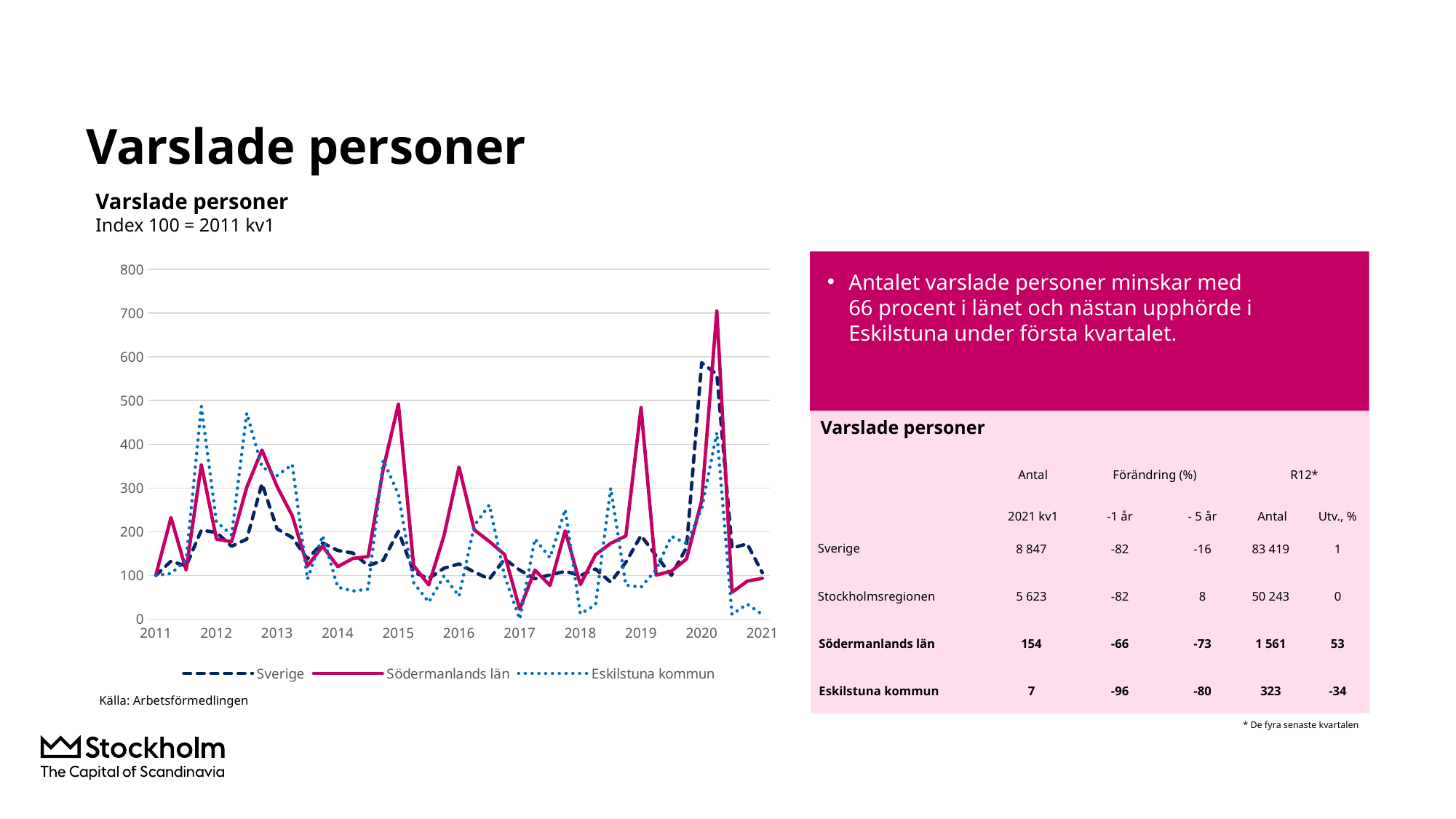
What kind of chart is shown on the slide? line chart Is the peak value for Södermanlands län in 2015 greater or less than 400? greater How many series does the chart legend list? 3 What is the title of the chart? Varslade personer Is the peak value for Eskilstuna kommun in 2020 greater or less than 500? less Which series reaches the highest value anywhere on the chart? Södermanlands län How many year labels are shown on the x axis? 11 Is the peak value for Sverige in 2020 greater or less than 500? greater Which series are listed in the chart legend? Sverige, Södermanlands län, Eskilstuna kommun Which series has the higher peak in 2020, Sverige or Eskilstuna kommun? Sverige What is the index value of all series at 2011 kv1, according to the chart subtitle? 100